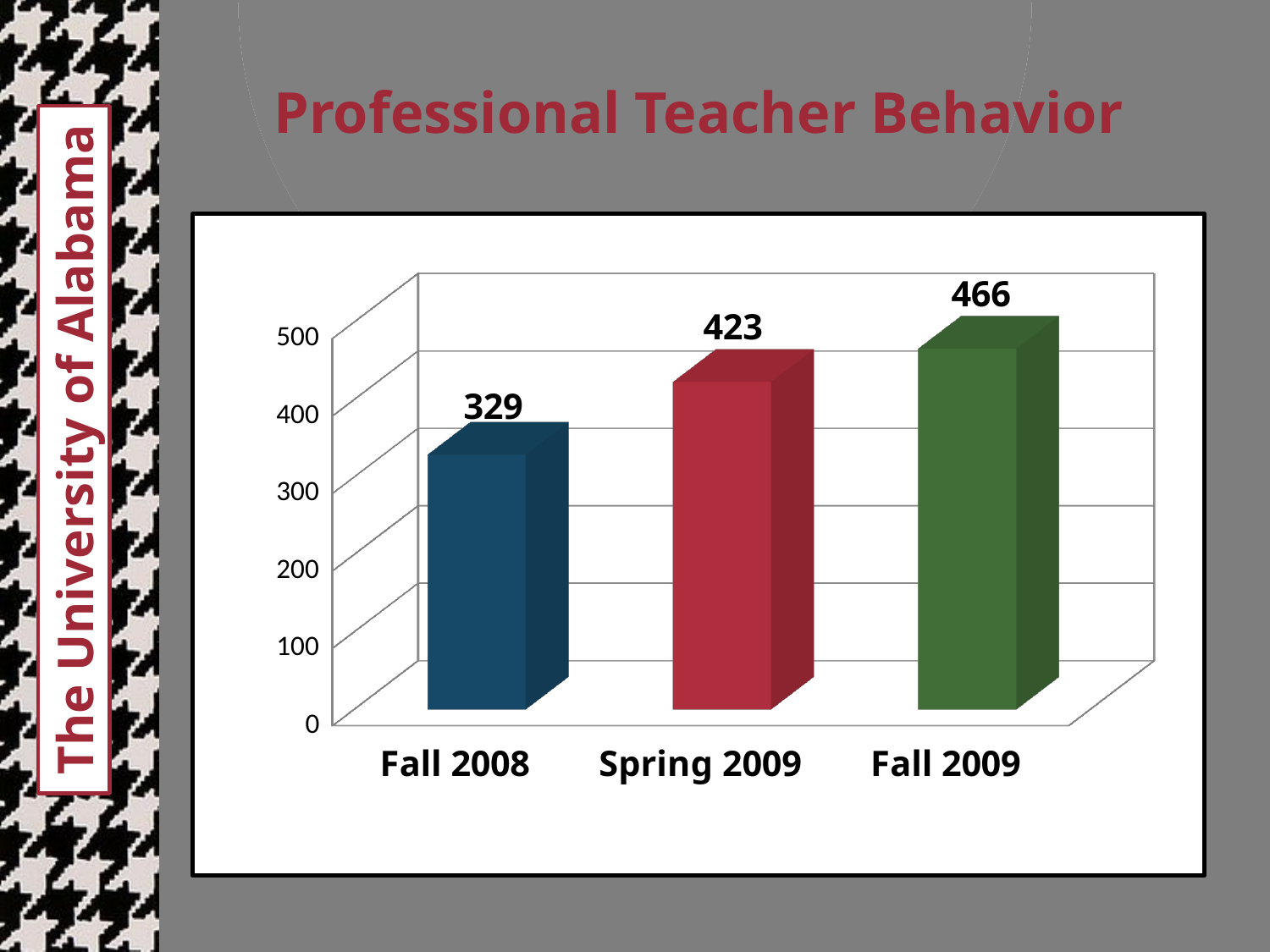
Which category has the lowest value? Fall 2008 Which is larger, the value for Spring 2009 or the value for Fall 2009? Fall 2009 What is the value for Fall 2009? 466 What kind of chart is shown on the slide? bar chart Do the values rise or fall from Fall 2008 to Fall 2009? rise Is the value for Fall 2008 greater or less than 400? less What is the difference between the values for Fall 2009 and Fall 2008? 137 Which category has the highest value? Fall 2009 How many categories are shown on the x axis? 3 What is the value for Spring 2009? 423 What is the value for Fall 2008? 329 What is the difference between the values for Spring 2009 and Fall 2008? 94